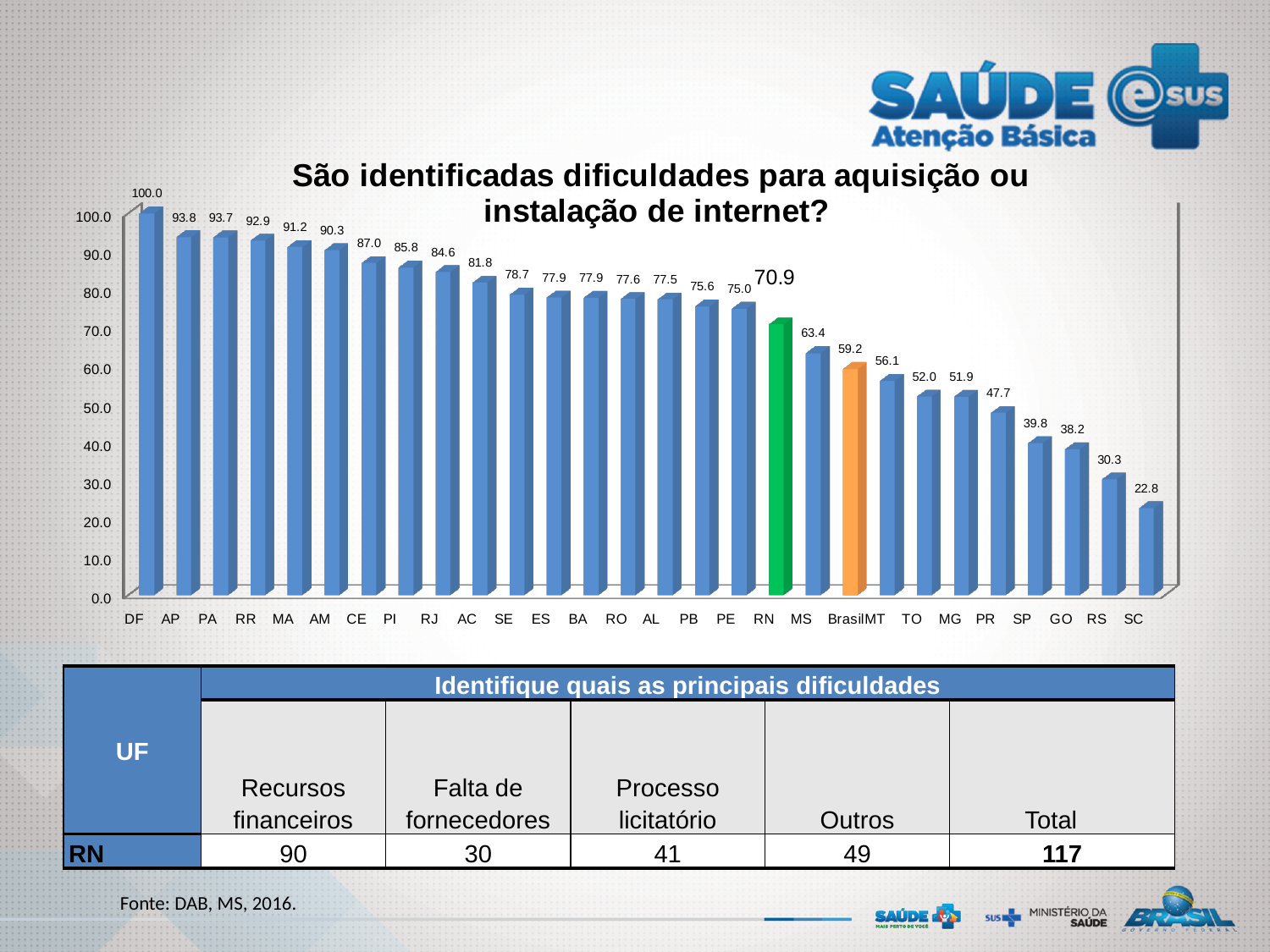
Do the values rise or fall from left to right along the x axis? fall What is the value for SP in the chart? 39.8 What colour is the bar for RN in the chart? green Is the value for PR greater or less than 50.0? less What is the difference between the values for RN and Brasil? 11.7 What kind of chart is shown on the slide? bar chart Which category has the highest value in the chart? DF What is the value for Brasil in the chart? 59.2 What is the value for RN in the chart? 70.9 Which has a larger value, MS or MT? MS Which category has the lowest value in the chart? SC How many categories are shown on the x axis of the chart? 28